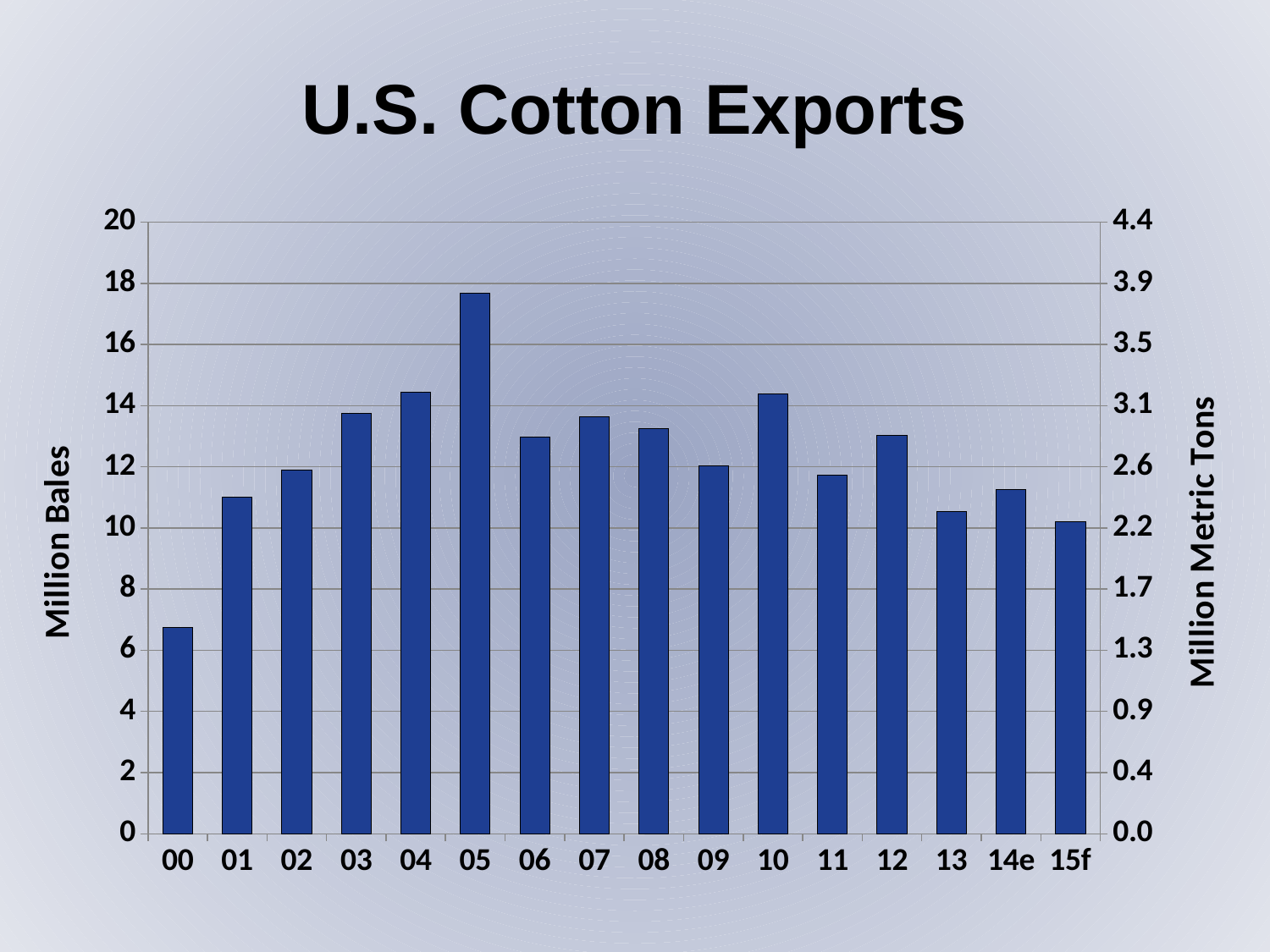
Is the value for 10 greater or less than 12 million bales? greater What kind of chart is shown on the slide? bar chart Which year has the lowest cotton exports? 00 What is the title of the chart? U.S. Cotton Exports Is the value for 05 greater or less than 16 million bales? greater How many years (categories) are shown on the x axis? 16 Which year has higher exports, 04 or 05? 05 Which year has higher exports, 09 or 10? 10 What is the label on the left vertical axis? Million Bales Is the value for 00 greater or less than 8 million bales? less Which year has the highest cotton exports? 05